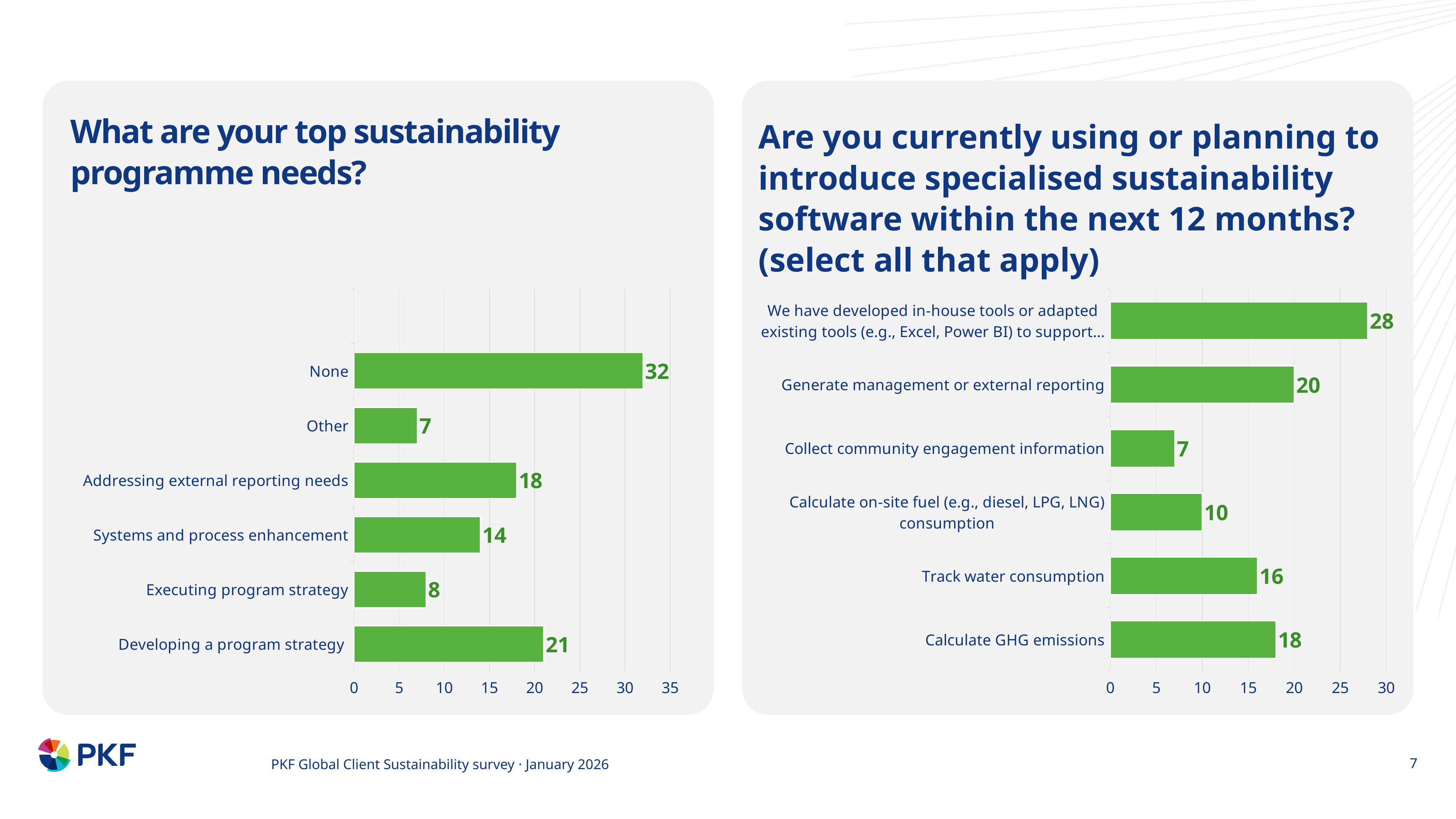
In the right chart (specialised sustainability software), which category has the lowest value? Collect community engagement information In the right chart (specialised sustainability software), which is larger: Generate management or external reporting or Calculate GHG emissions? Generate management or external reporting In the right chart (specialised sustainability software), which category has the highest value? We have developed in-house tools or adapted existing tools (e.g., Excel, Power BI) to support... In the left chart (top sustainability programme needs), what is the value for None? 32 In the left chart (top sustainability programme needs), what is the difference between Developing a program strategy and Executing program strategy? 13 In the right chart (specialised sustainability software), what is the value for Track water consumption? 16 What type of chart is the left chart (top sustainability programme needs)? Bar chart In the left chart (top sustainability programme needs), what is the value for Systems and process enhancement? 14 In the right chart (specialised sustainability software), what is the difference between Calculate GHG emissions and Calculate on-site fuel consumption? 8 In the left chart (top sustainability programme needs), how many categories are shown? 6 In the left chart (top sustainability programme needs), which category has the lowest value? Other In the right chart (specialised sustainability software), how many categories are shown? 6